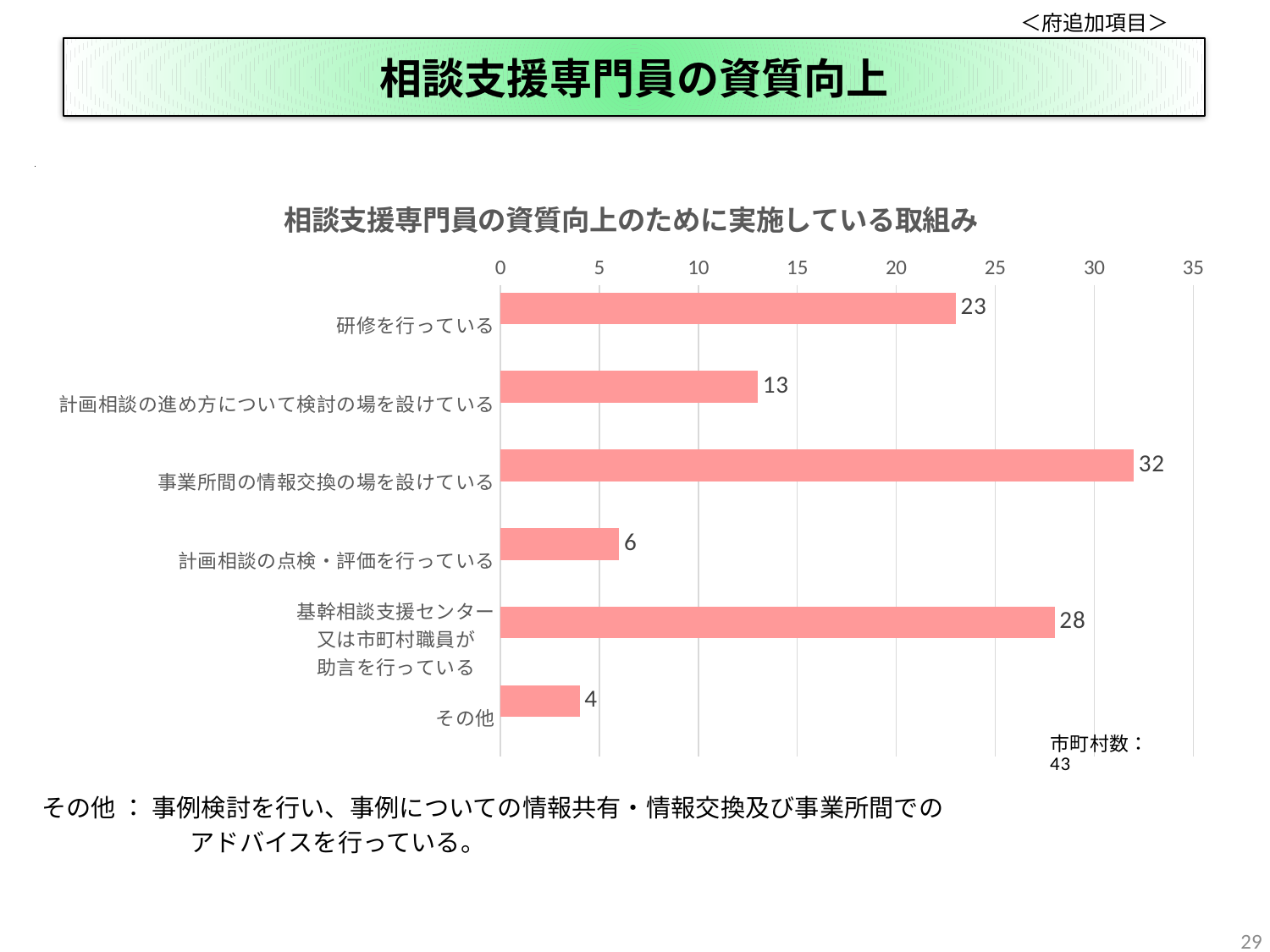
Which category has the highest value? 事業所間の情報交換の場を設けている Which category has the lowest value? その他 What is the title of the chart? 相談支援専門員の資質向上のために実施している取組み What is the value for 事業所間の情報交換の場を設けている? 32 Which is larger, the value for 基幹相談支援センター又は市町村職員が助言を行っている or the value for 研修を行っている? 基幹相談支援センター又は市町村職員が助言を行っている What is the value for 研修を行っている? 23 What kind of chart is shown on the slide? bar chart What is the value for 基幹相談支援センター又は市町村職員が助言を行っている? 28 What is the value for その他? 4 How many categories are shown in the chart? 6 Is the value for 計画相談の点検・評価を行っている greater or less than 10? less What is the difference between the values for 研修を行っている and 計画相談の進め方について検討の場を設けている? 10